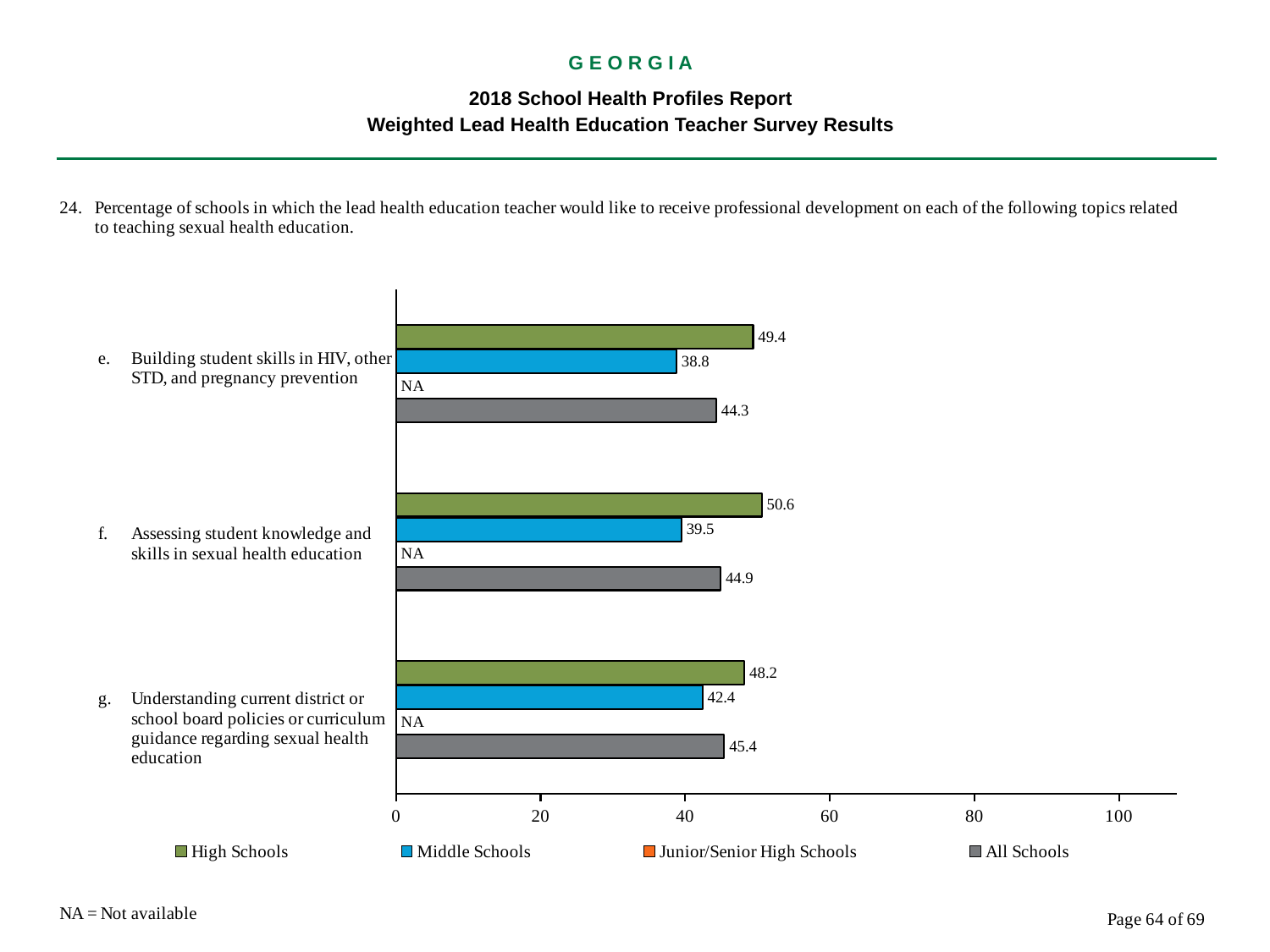
Which is larger for 'Building student skills in HIV, other STD, and pregnancy prevention': the High Schools value or the All Schools value? High Schools What is the All Schools value for 'Understanding current district or school board policies or curriculum guidance regarding sexual health education'? 45.4 What is the High Schools value for 'Assessing student knowledge and skills in sexual health education'? 50.6 What is the Middle Schools value for 'Building student skills in HIV, other STD, and pregnancy prevention'? 38.8 How many topics (categories) are shown on the chart? 3 How many series does the legend list? 4 Which topic has the highest High Schools value? Assessing student knowledge and skills in sexual health education What is shown for Junior/Senior High Schools for 'Assessing student knowledge and skills in sexual health education'? NA Which topic has the lowest Middle Schools value? Building student skills in HIV, other STD, and pregnancy prevention What is the difference between the High Schools and Middle Schools values for 'Understanding current district or school board policies or curriculum guidance regarding sexual health education'? 5.8 What kind of chart is shown on the slide? bar chart Is the Middle Schools value for 'Assessing student knowledge and skills in sexual health education' greater or less than 40? less